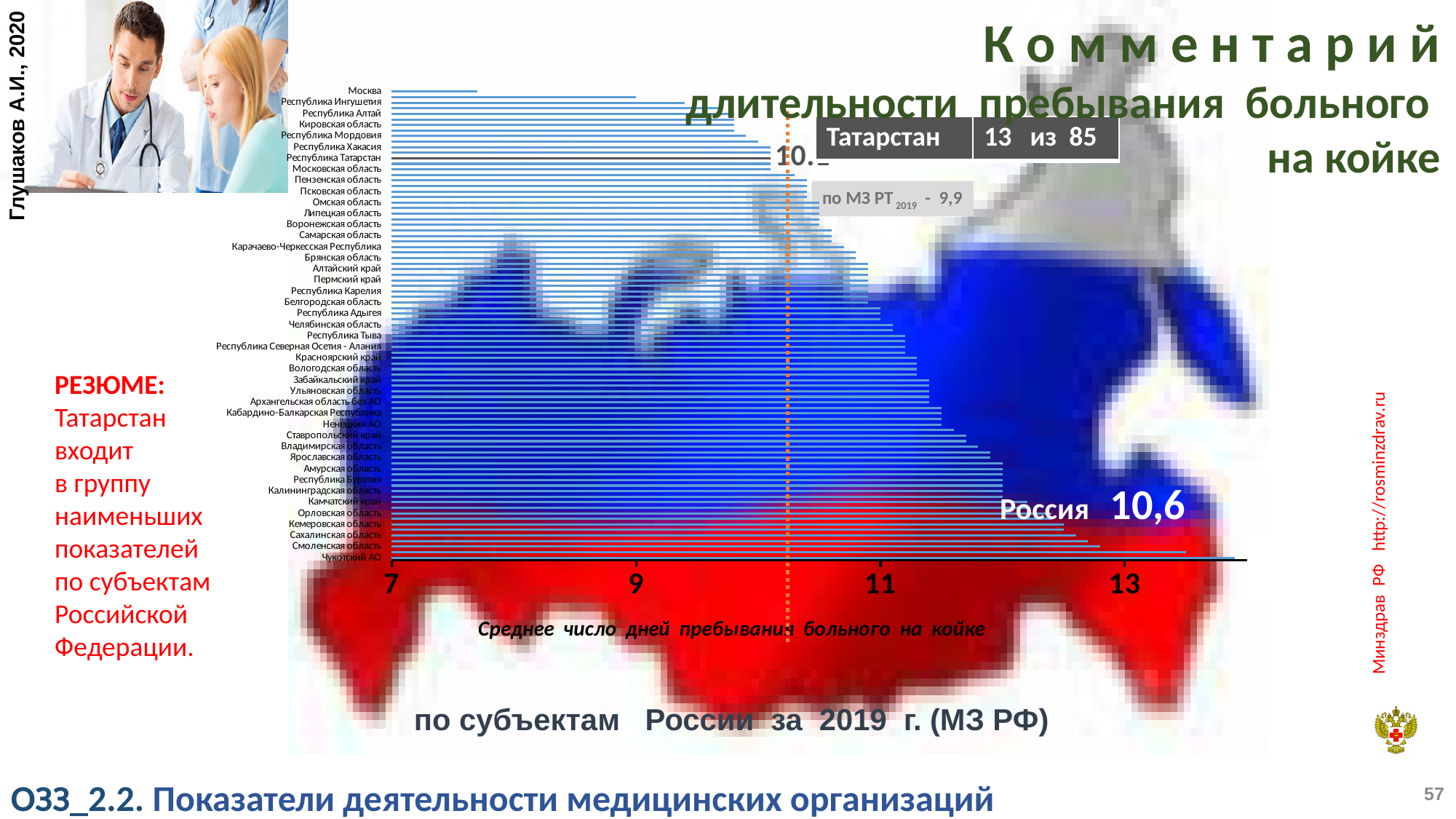
Is the value for Чукотский АО greater or less than 13? greater Is the value for Москва greater or less than 9? less Which has the larger value, Москва or Чукотский АО? Чукотский АО What is the title of the horizontal axis of the chart? Среднее число дней пребывания больного на койке Is the value for Московская область greater or less than 11? less Which has the larger value, Московская область or Кемеровская область? Кемеровская область What kind of chart is shown on the slide? bar chart Which region has the longest bar in the chart? Чукотский АО What is the average length of stay value shown for Россия? 10,6 Do the bar values increase or decrease going from the top of the chart to the bottom? increase Which region has the shortest bar in the chart? Москва